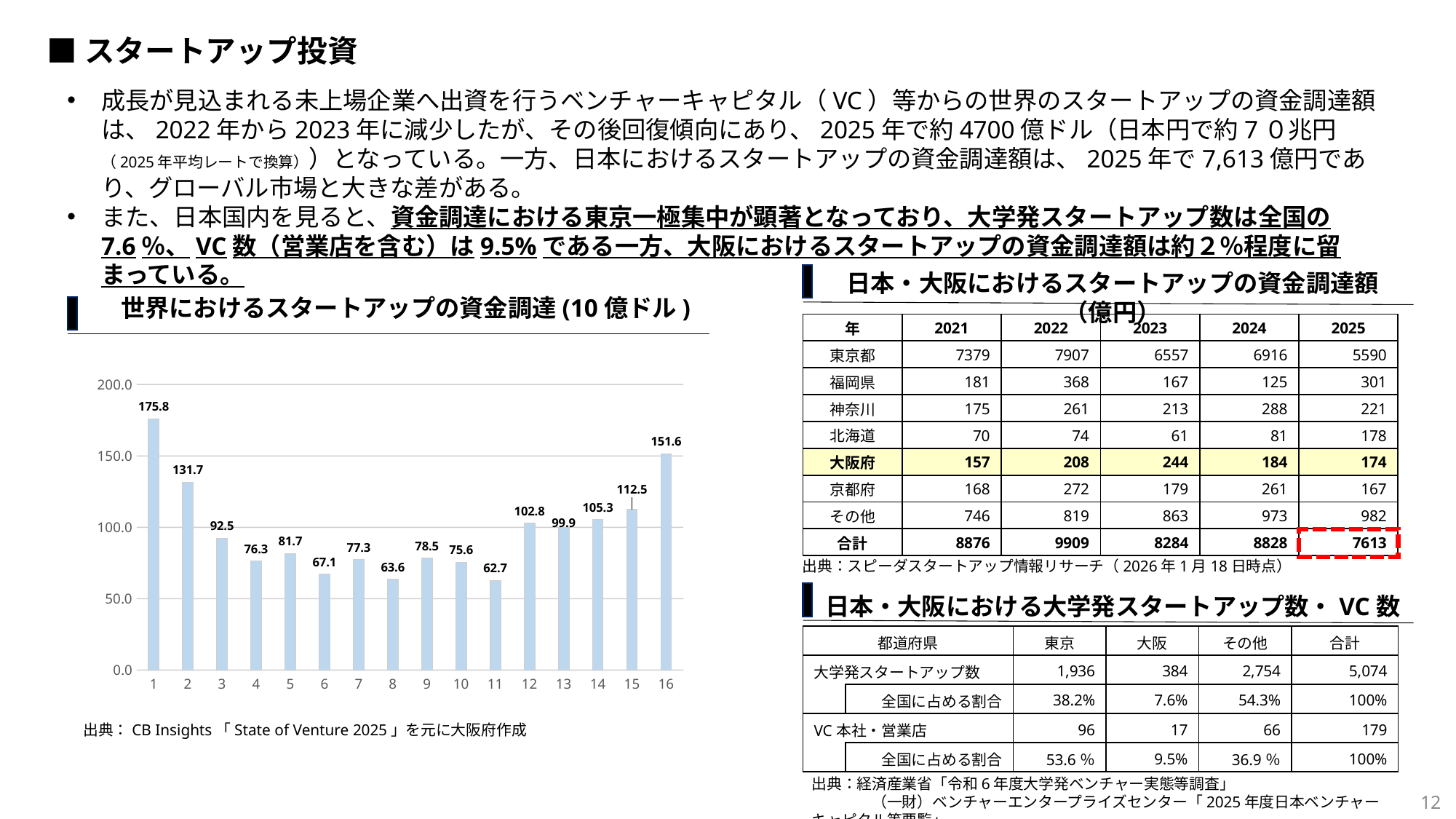
Which category has the lowest value in the chart? 11 What is the difference between the values for category 1 and category 2? 44.1 What type of chart is shown on the slide? bar chart How many bars are plotted in the chart? 16 Do the values rise or fall from category 1 to category 4? fall What is the value for category 11 in the chart? 62.7 Is the value for category 15 greater or less than 100.0? greater Which is larger, the value for category 12 or the value for category 13? 12 What is the value for category 1 in the chart? 175.8 Which category has the highest value in the chart? 1 What is the value for category 16 in the chart? 151.6 What is the title of the chart? 世界におけるスタートアップの資金調達 (10億ドル)